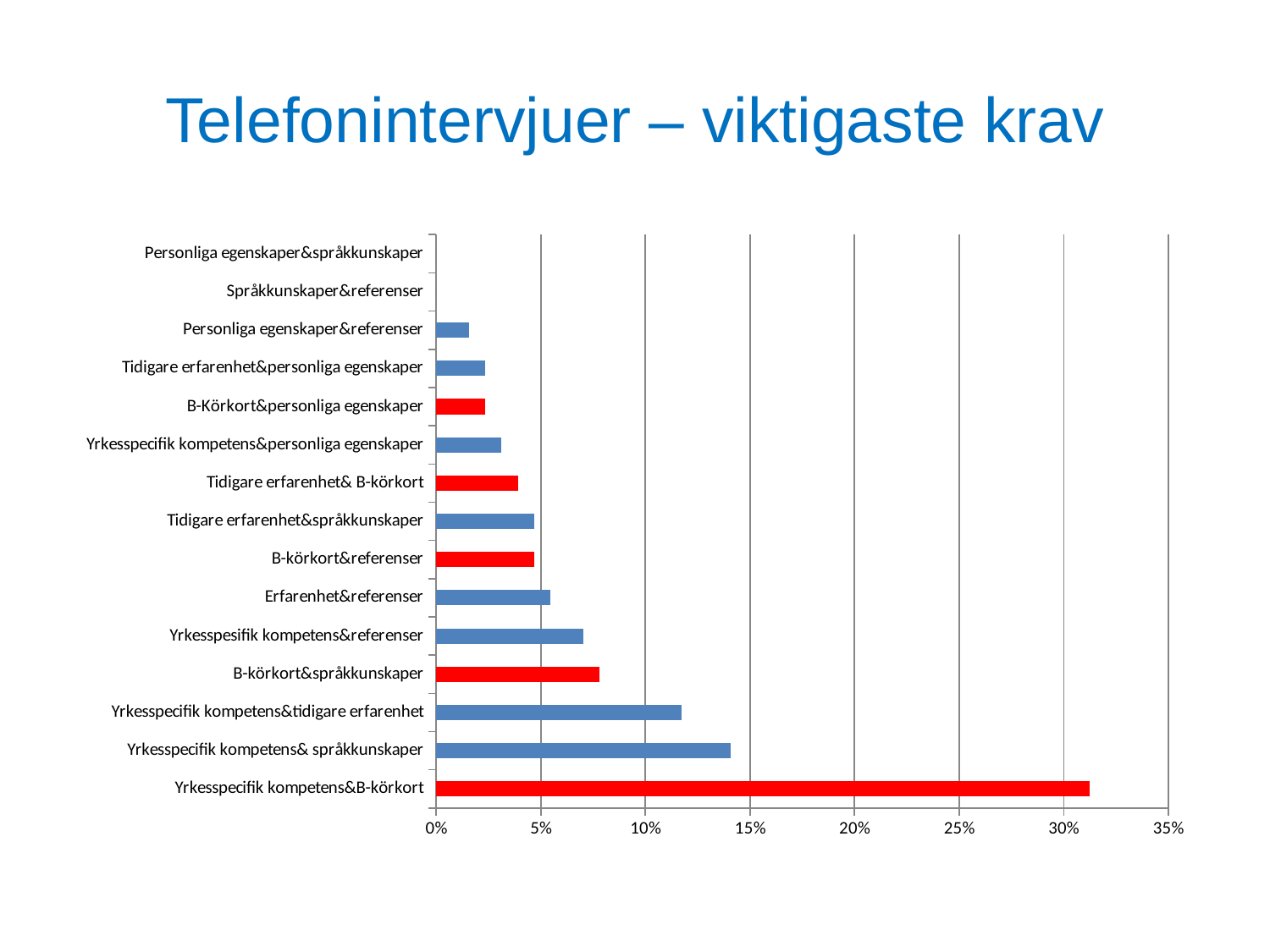
Is the value for Yrkesspecifik kompetens& språkkunskaper greater or less than 10%? greater What is the title of the slide? Telefonintervjuer – viktigaste krav What kind of chart is shown on the slide? Bar chart How many categories are listed on the vertical axis of the chart? 15 Is the value for Personliga egenskaper&referenser greater or less than 5%? less Is the value for B-körkort&språkkunskaper greater or less than 5%? greater Which category has the highest value? Yrkesspecifik kompetens&B-körkort Which is larger: Yrkesspecifik kompetens& språkkunskaper or Yrkesspecifik kompetens&tidigare erfarenhet? Yrkesspecifik kompetens& språkkunskaper Which is larger: Tidigare erfarenhet& B-körkort or B-Körkort&personliga egenskaper? Tidigare erfarenhet& B-körkort What colour is the bar for Yrkesspecifik kompetens&B-körkort? Red